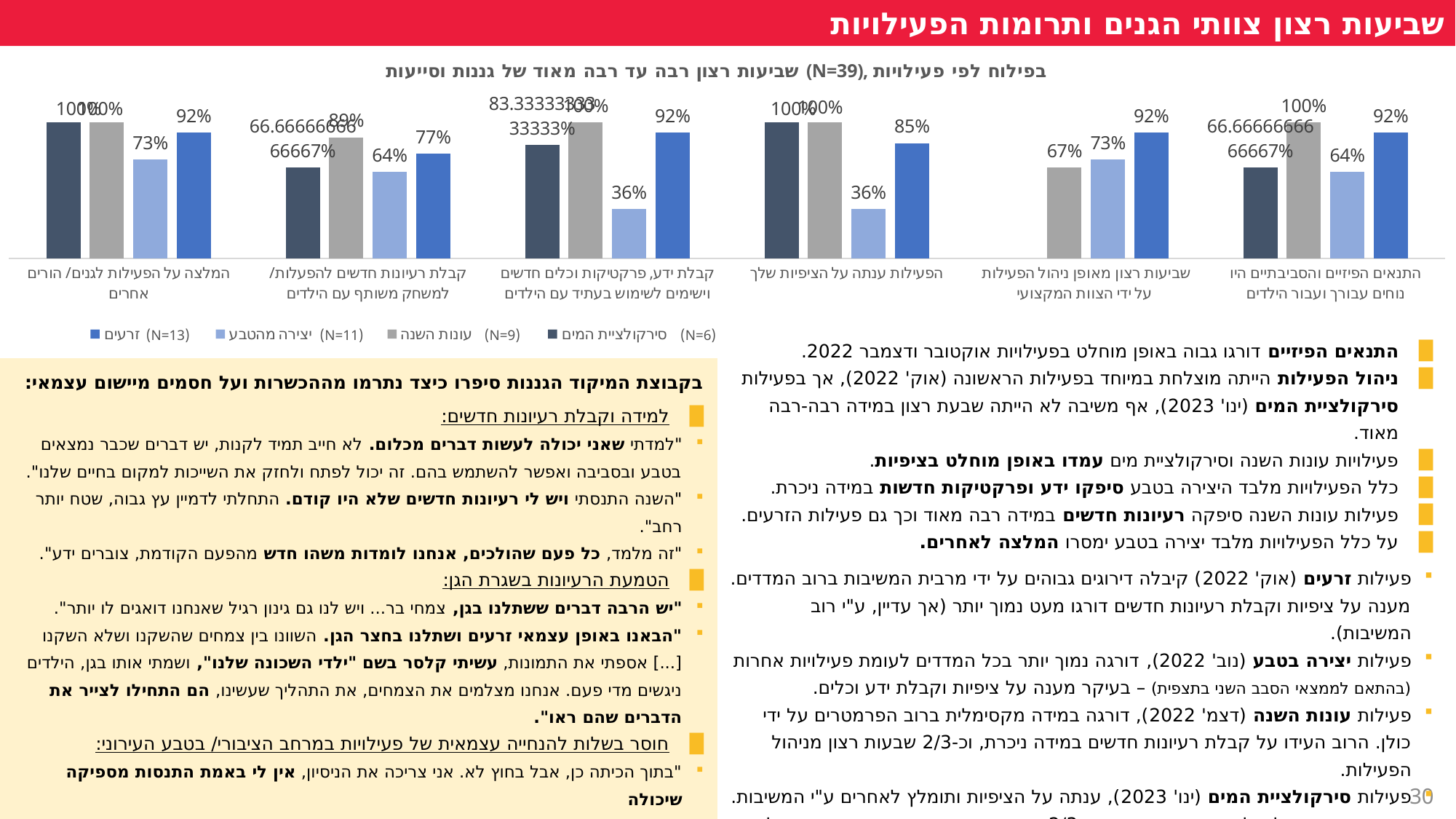
How many series does the chart legend list? 4 In the category שביעות רצון מאופן ניהול הפעילות על ידי הצוות המקצועי, which is larger: זרעים (N=13) or יצירה מהטבע (N=11)? זרעים (N=13) What is the value for עונות השנה (N=9) in the category שביעות רצון מאופן ניהול הפעילות על ידי הצוות המקצועי? 67% What is the value for עונות השנה (N=9) in the category קבלת רעיונות חדשים להפעלות/ למשחק משותף עם הילדים? 89% What is the value for יצירה מהטבע (N=11) in the category המלצה על הפעילות לגנים/ הורים אחרים? 73% How many categories are shown along the x axis of the chart? 6 What is the value for יצירה מהטבע (N=11) in the category הפעילות ענתה על הציפיות שלך? 36% What kind of chart is shown on the slide? bar chart Which series has the lowest value in the category קבלת ידע, פרקטיקות וכלים חדשים וישימים לשימוש בעתיד עם הילדים? יצירה מהטבע (N=11) Which series is shown in light blue in the chart legend? יצירה מהטבע (N=11) What is the difference between זרעים (N=13) and יצירה מהטבע (N=11) in the category קבלת רעיונות חדשים להפעלות/ למשחק משותף עם הילדים? 13% What is the value for זרעים (N=13) in the category הפעילות ענתה על הציפיות שלך? 85%